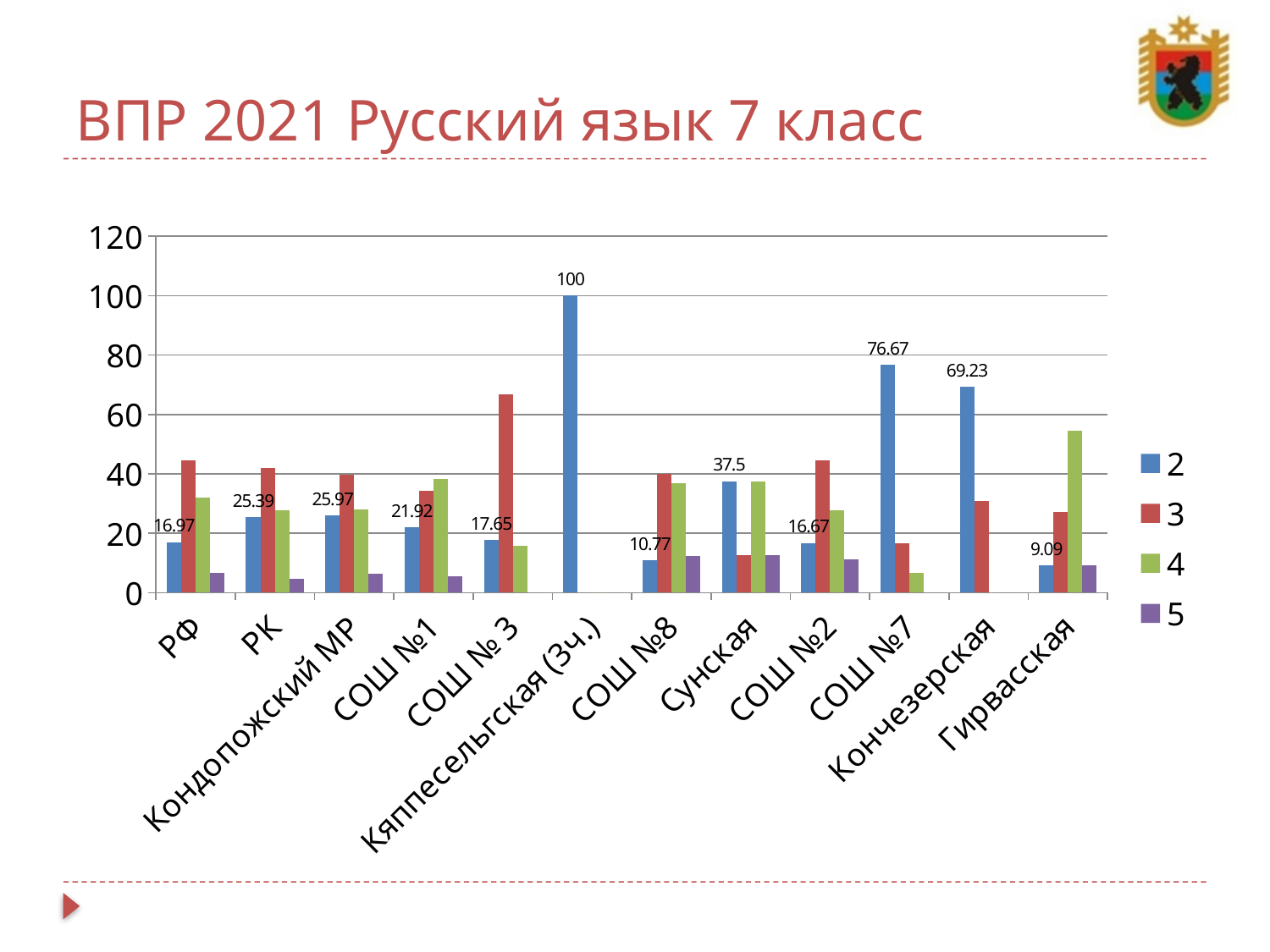
What is the value of series "2" for Сунская? 37.5 Which category has the lowest value for series "2"? Гирвасская How many series does the legend list? 4 Is the value of series "3" for СОШ № 3 greater or less than 60? greater What is the difference between the series "2" values for СОШ №7 and Кончезерская? 7.44 How many categories are shown on the x axis? 12 What kind of chart is shown on the slide? bar chart Is the value of series "4" for Гирвасская greater or less than 40? greater Which category has the highest value for series "2"? Кяппесельгская (3ч.) Which has the larger series "2" value, Сунская or РК? Сунская What is the value of series "2" for СОШ №7? 76.67 What is the value of series "2" for РФ? 16.97